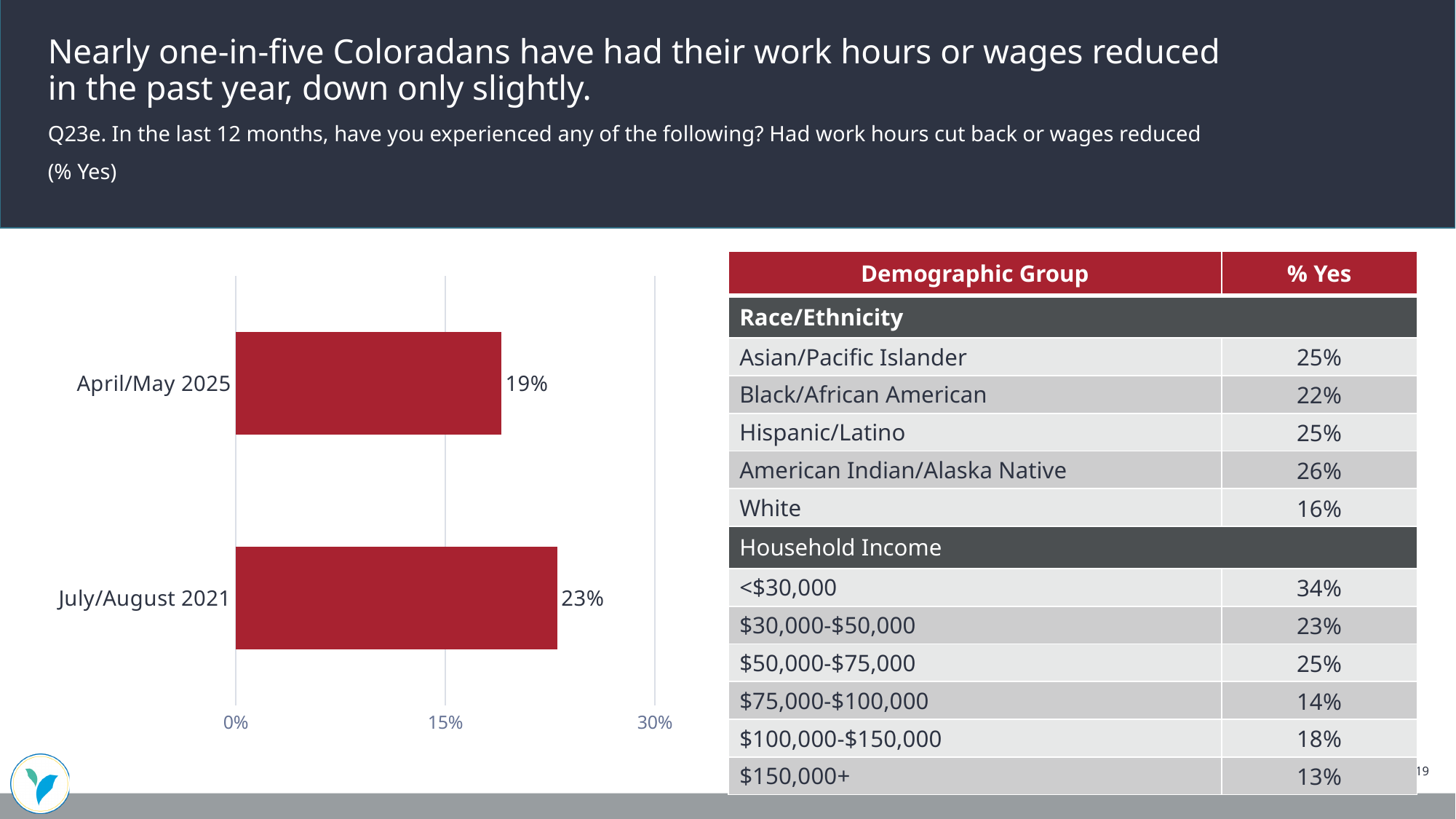
What is the value for July/August 2021? 23% What is the difference between the July/August 2021 value and the April/May 2025 value? 4% Which category has the higher value, April/May 2025 or July/August 2021? July/August 2021 What is the value for April/May 2025? 19% What colour are the bars in the chart? Red Is the value for July/August 2021 greater or less than 15%? greater What is the highest value shown on the x axis of the chart? 30% Which category has the lowest value? April/May 2025 How many categories are shown in the bar chart? 2 Is the value for April/May 2025 greater or less than 30%? less What kind of chart is shown on the slide? Bar chart